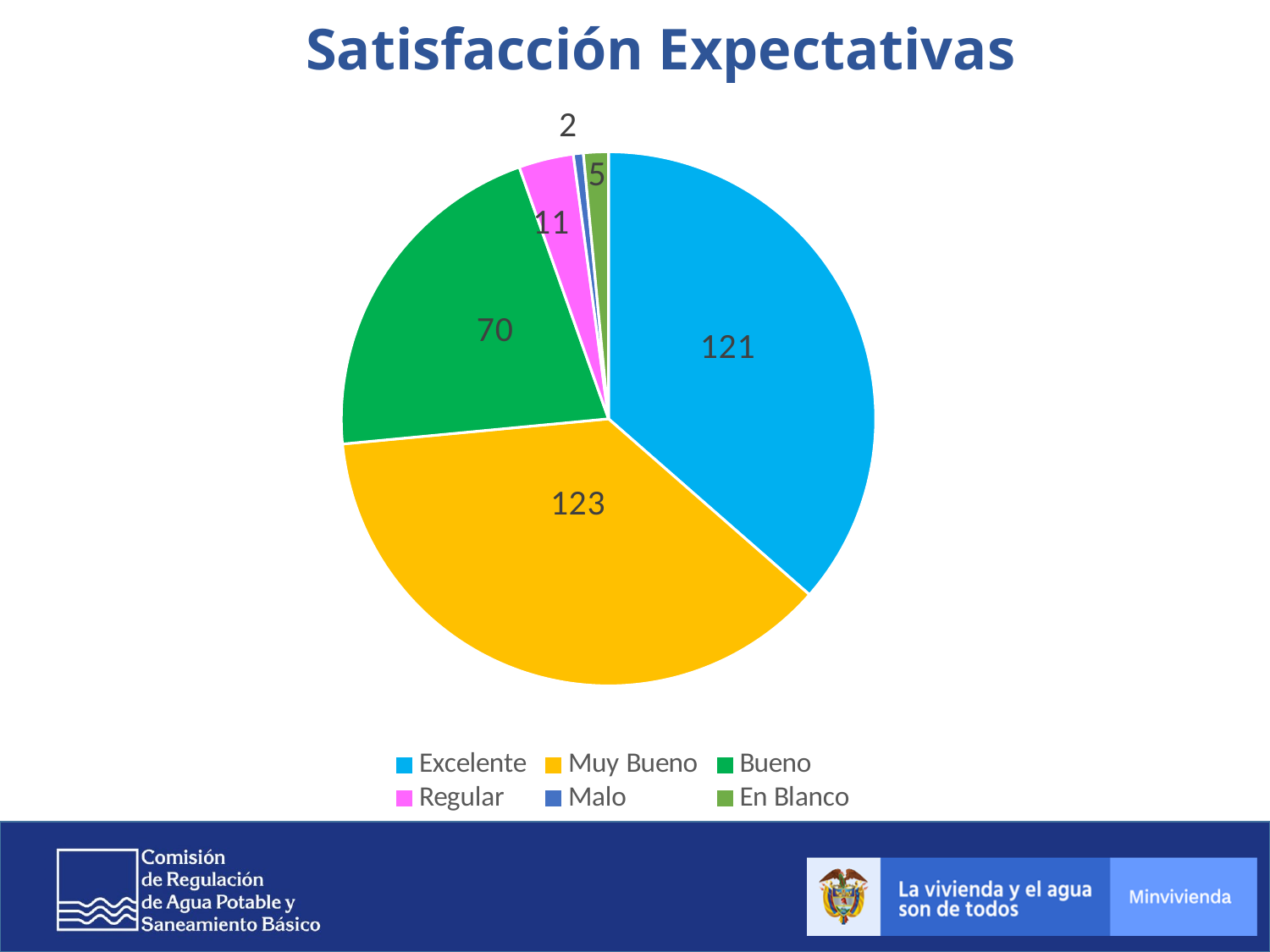
What is the difference between the values for Muy Bueno and Bueno? 53 What is the value for Bueno? 70 Which is larger, the value for Regular or the value for En Blanco? Regular Which category has the largest slice? Muy Bueno What is the value for Excelente? 121 What is the value for Malo? 2 What is the title of the chart? Satisfacción Expectativas How many categories does the legend list? 6 Which category has the smallest slice? Malo What is the value for Regular? 11 What type of chart is shown on the slide? pie chart What is the value for Muy Bueno? 123